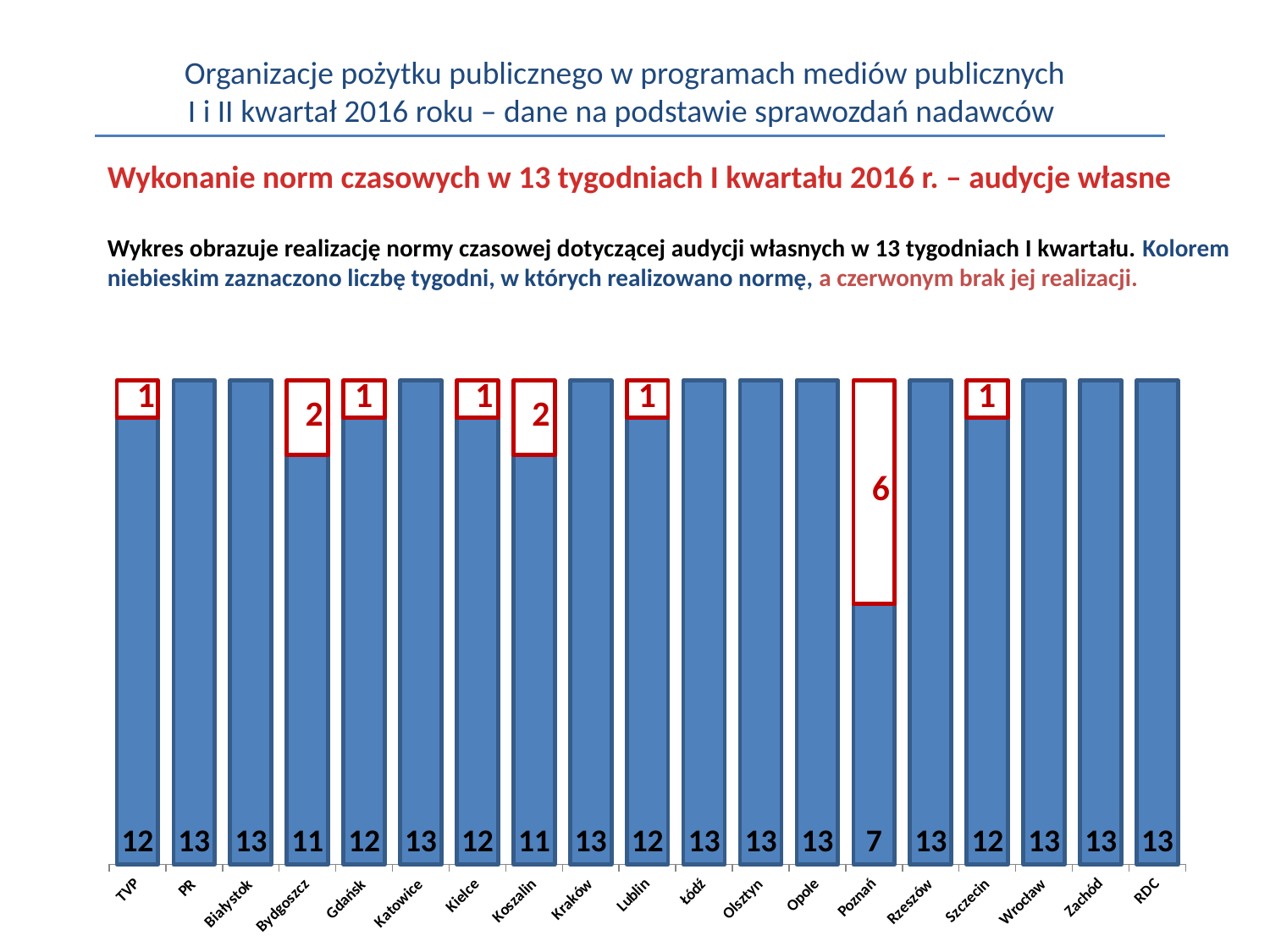
What is the blue value for Bydgoszcz? 11 What is the difference between the blue values for Katowice and Poznań? 6 What is the red value (weeks without the norm met) for Poznań? 6 What colour marks the weeks in which the norm was not met? red Which broadcaster has the highest red value (most weeks without the norm met)? Poznań What is the blue value (weeks with the norm met) for Poznań? 7 How many categories (broadcasters) are shown on the x axis of the chart? 19 Which has a larger blue value, Gdańsk or Koszalin? Gdańsk What is the red value for Koszalin? 2 Which broadcaster has the lowest blue value (fewest weeks with the norm met)? Poznań What kind of chart is shown on the slide? bar chart What is the total of the stacked bar for Bydgoszcz (blue plus red)? 13